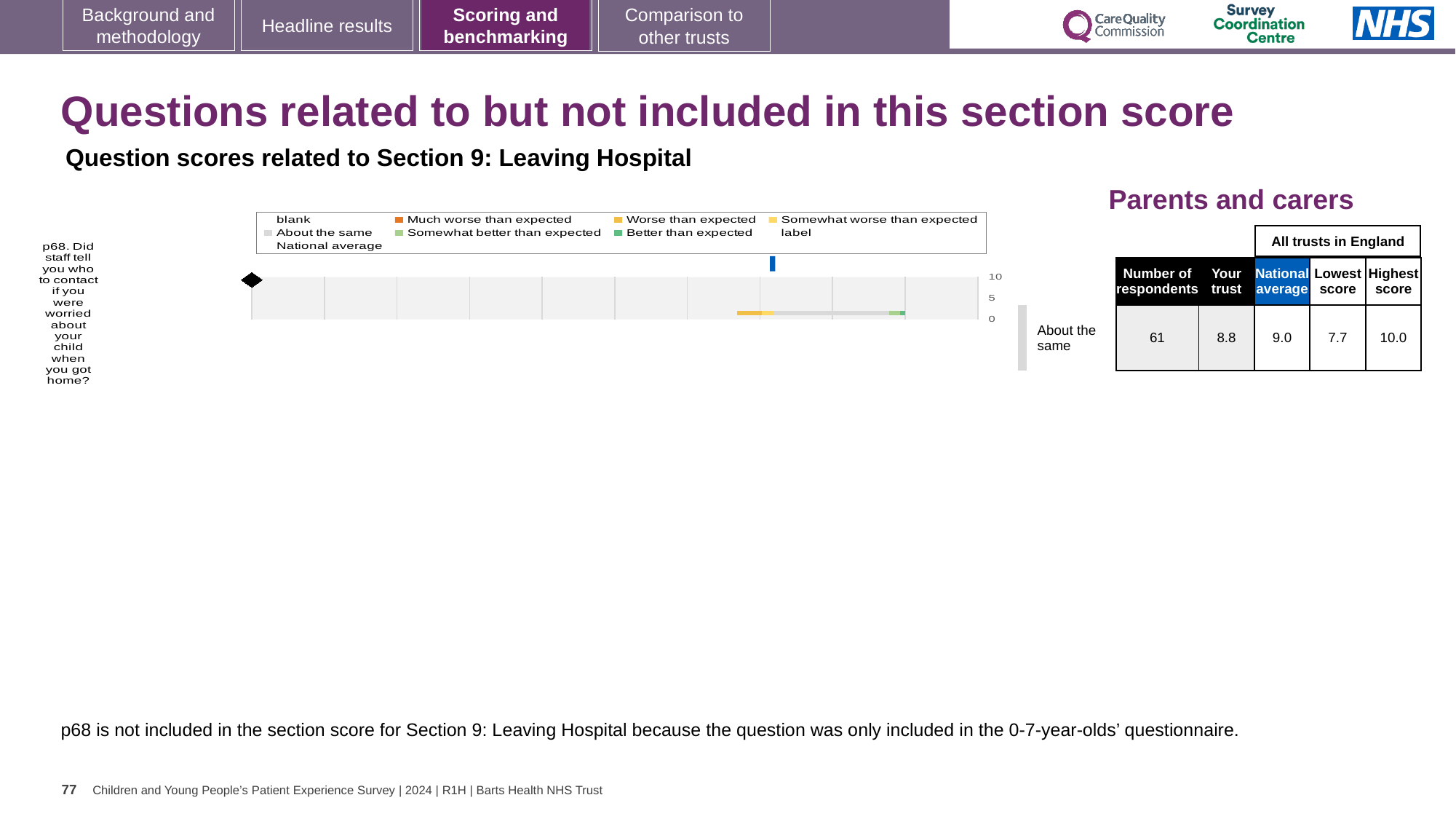
Which is larger for p68: the trust's score or the national average? National average How many respondents answered the p68 question plotted in the chart? 61 What rating category is shown next to the chart for p68? About the same How many entries does the chart legend list? 9 How many survey questions are plotted in the chart? 1 Which question is plotted in the chart? p68. Did staff tell you who to contact if you were worried about your child when you got home? Is the national average marker for p68 on the chart greater or less than 5? greater What is the highest value shown on the chart's axis? 10 According to the slide, what is the trust's score for the p68 question plotted in the chart? 8.8 What is the difference between the highest score (10.0) and the lowest score (7.7) for p68? 2.3 According to the slide, what is the national average for the p68 question plotted in the chart? 9.0 What kind of chart is used to show the p68 question score? bar chart